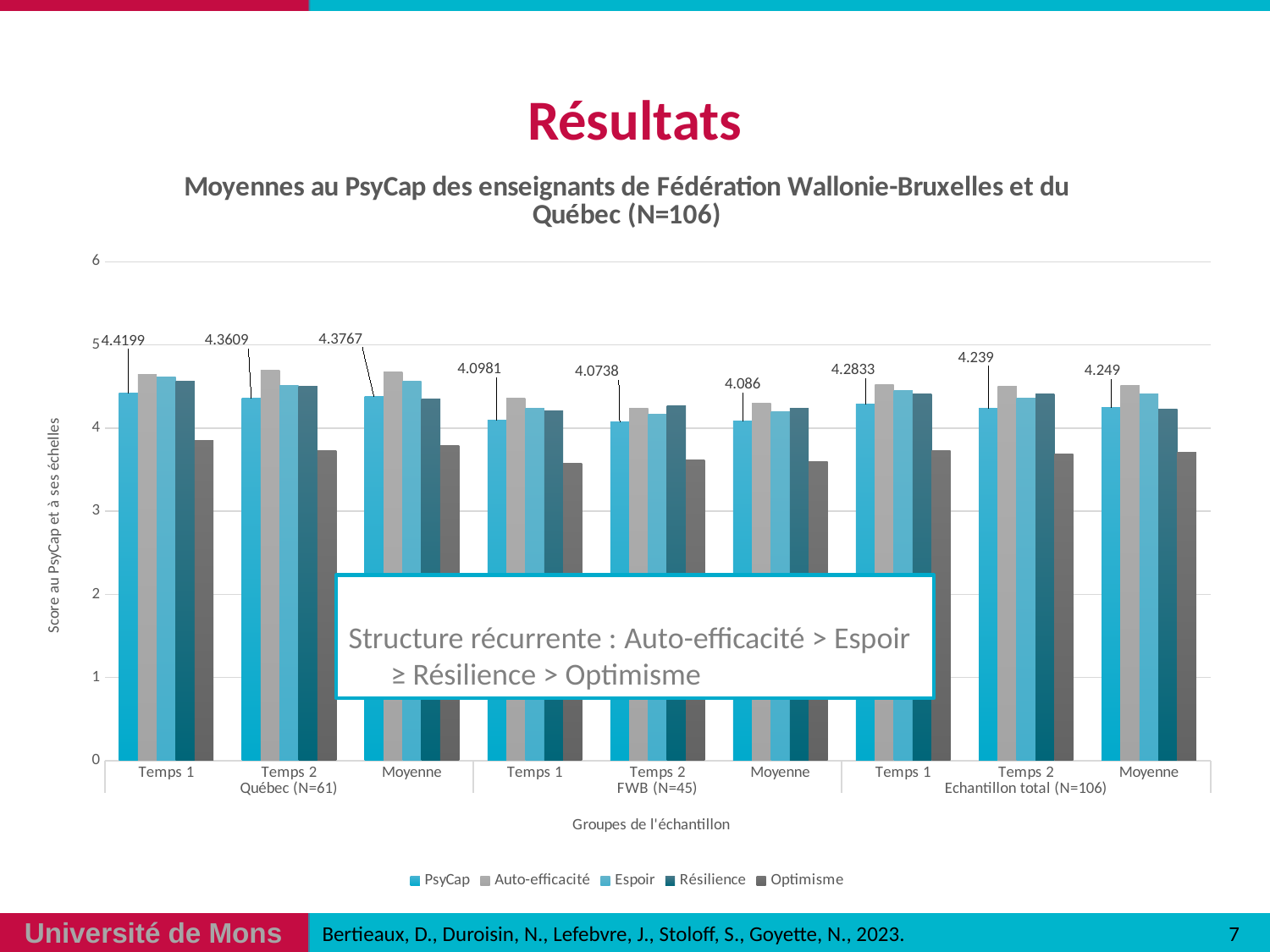
What is the PsyCap value for Moyenne in the FWB (N=45) group? 4.086 Which category has the lowest PsyCap value? Temps 2, FWB (N=45) What is the title of the vertical axis? Score au PsyCap et à ses échelles Which is larger: the PsyCap value for Moyenne in Québec (N=61) or for Moyenne in FWB (N=45)? Moyenne in Québec (N=61) What is the difference between the PsyCap values for Temps 1 and Temps 2 in the Québec (N=61) group? 0.059 What kind of chart is shown on the slide? bar chart Which category has the highest PsyCap value? Temps 1, Québec (N=61) Is the Optimisme value for Temps 1 in the Québec (N=61) group greater or less than 4? less What is the PsyCap value for Temps 2 in the Echantillon total (N=106) group? 4.239 How many series does the legend list? 5 How many category groups are shown along the x axis? 9 What is the PsyCap value for Temps 1 in the Québec (N=61) group? 4.4199